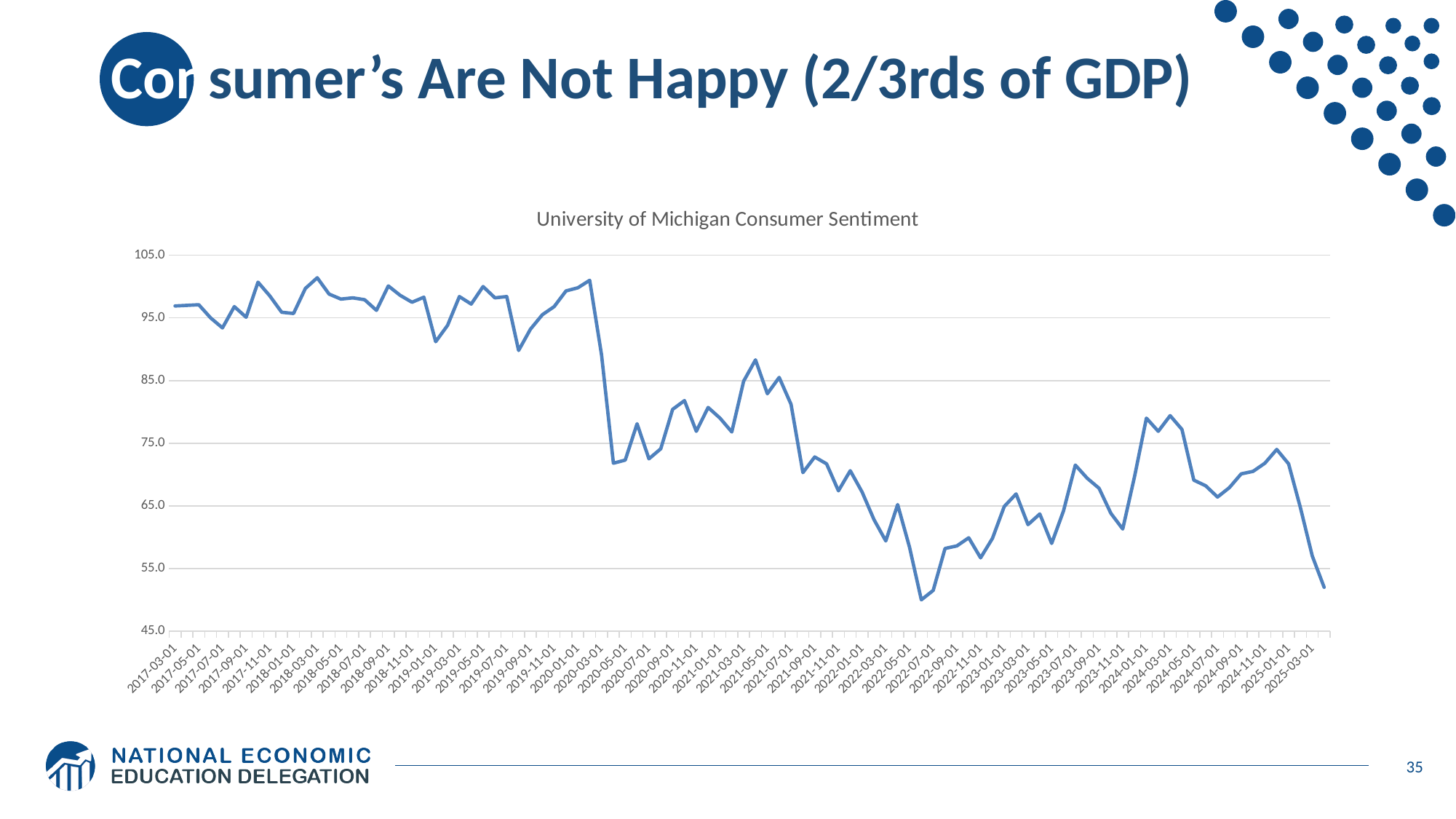
Is the value for 2021-05-01 greater or less than 75? greater Is the value for 2022-07-01 greater or less than 55? less In which year does the line reach its lowest point? 2022 What is the highest value shown on the y axis of the chart? 105.0 Is the value for 2023-05-01 greater or less than 65? less What is the title of the chart? University of Michigan Consumer Sentiment Which is larger, the value for 2017-03-01 or the value for 2025-03-01? 2017-03-01 Overall, does consumer sentiment rise or fall from 2017-03-01 to 2025-03-01? fall What kind of chart is shown on the slide? line chart